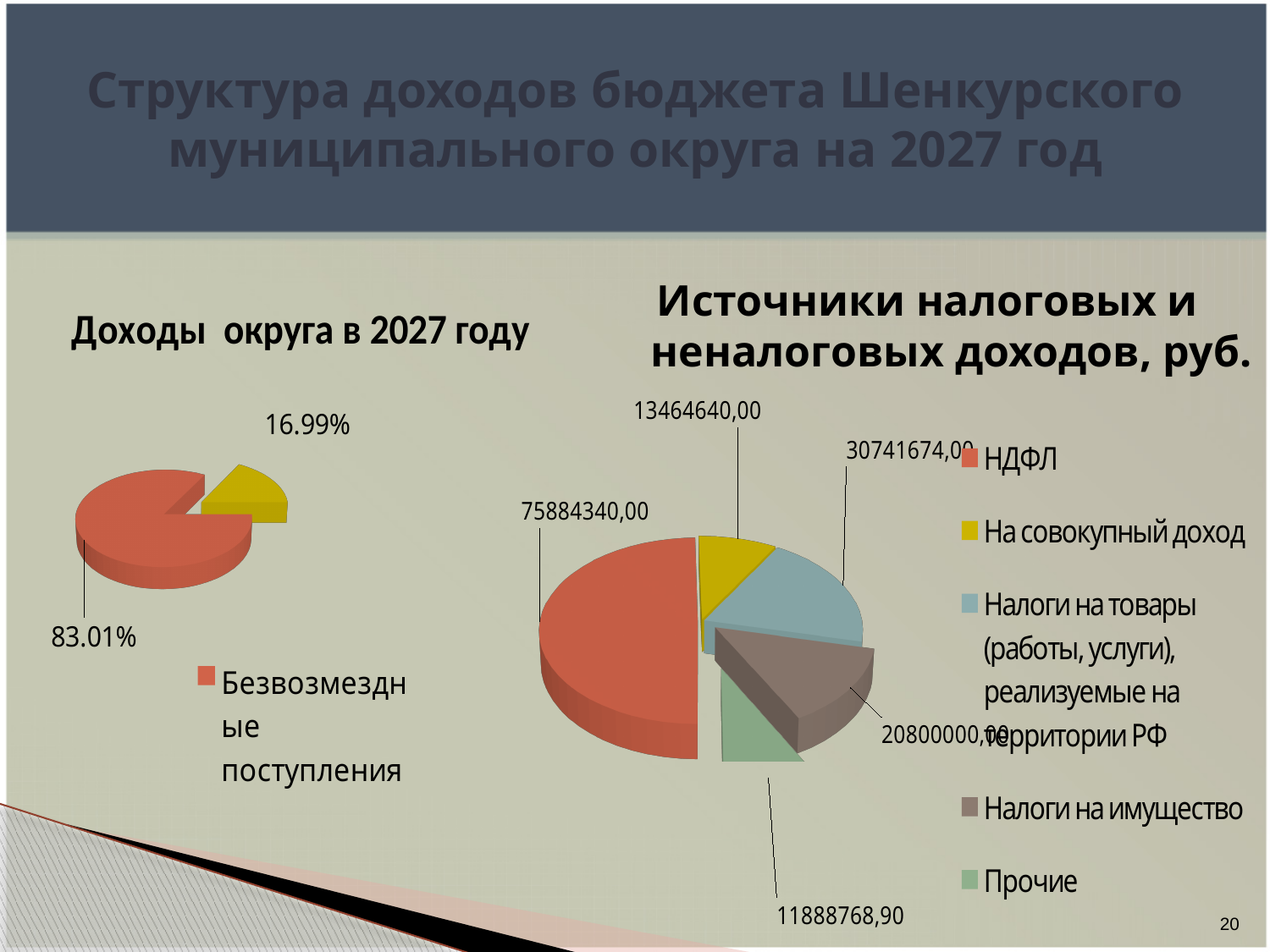
How many slices does the chart 'Доходы округа в 2027 году' have? 2 In the chart 'Источники налоговых и неналоговых доходов, руб.', what is the difference between the values for НДФЛ and Налоги на товары (работы, услуги), реализуемые на территории РФ? 45142666,00 In the chart 'Источники налоговых и неналоговых доходов, руб.', what is the value for Прочие? 11888768,90 In the chart 'Источники налоговых и неналоговых доходов, руб.', which is larger: На совокупный доход or Налоги на имущество? Налоги на имущество In the chart 'Доходы округа в 2027 году', what share of the pie is Безвозмездные поступления? 83.01% In the chart 'Источники налоговых и неналоговых доходов, руб.', what is the value for НДФЛ? 75884340,00 In the chart 'Источники налоговых и неналоговых доходов, руб.', which category has the smallest value? Прочие In the chart 'Источники налоговых и неналоговых доходов, руб.', what is the value for Налоги на имущество? 20800000,00 What kind of chart is the chart titled 'Источники налоговых и неналоговых доходов, руб.'? pie chart How many entries does the legend of the chart 'Источники налоговых и неналоговых доходов, руб.' list? 5 In the chart 'Источники налоговых и неналоговых доходов, руб.', which category has the largest value? НДФЛ In the chart 'Доходы округа в 2027 году', what share does the smaller (yellow) slice have? 16.99%